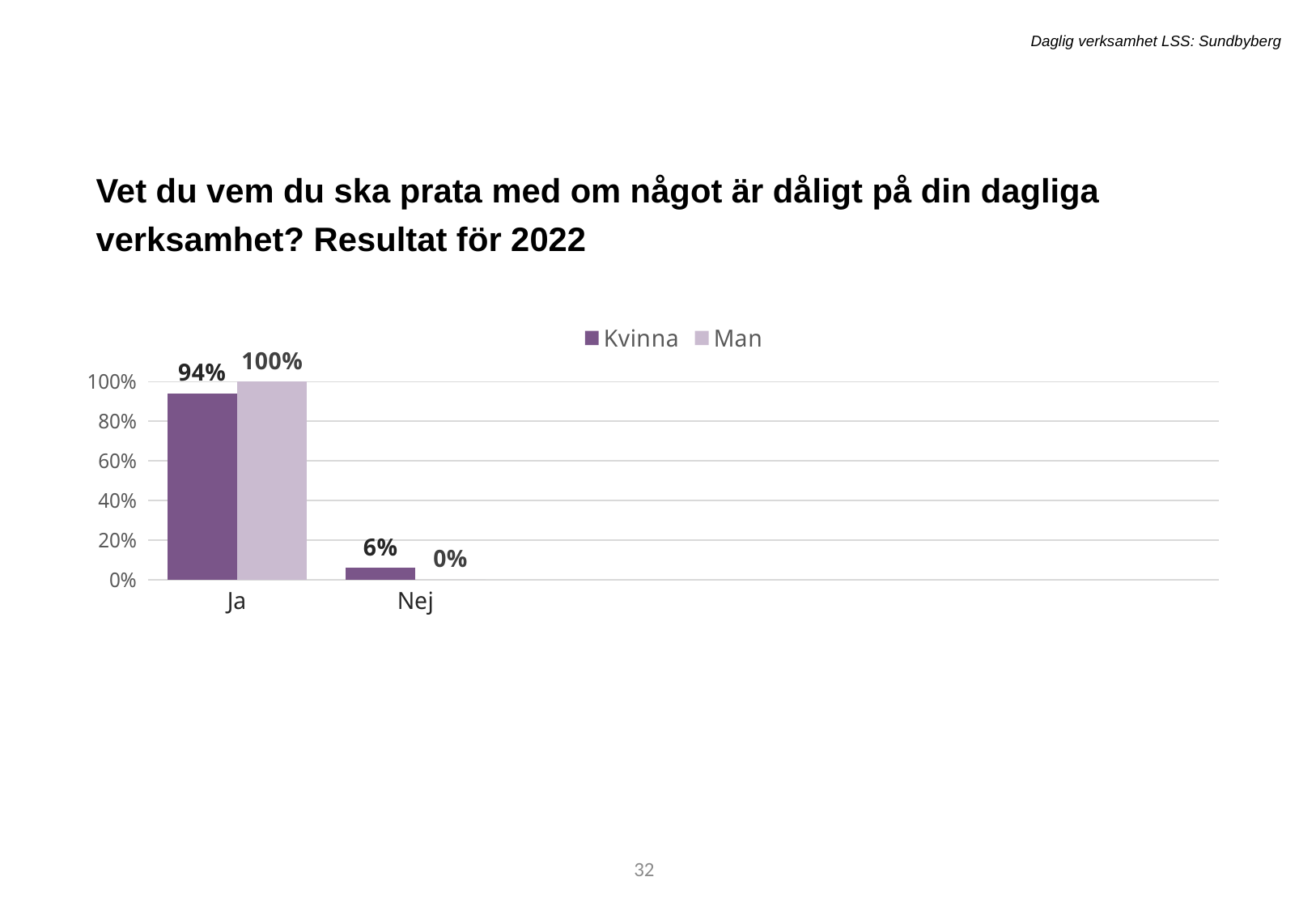
What kind of chart is shown on the slide? Bar chart What is the value for Kvinna in the Nej category? 6% Which series is shown in the darker purple colour? Kvinna How many series does the legend list? 2 Which category has the lowest value for Man? Nej Which is larger for Ja: Kvinna or Man? Man What is the value for Kvinna in the Ja category? 94% What is the value for Man in the Ja category? 100% What is the difference between the Man and Kvinna values for Ja? 6% How many categories are shown on the x axis? 2 What is the value for Man in the Nej category? 0% Which category has the highest value for Kvinna? Ja